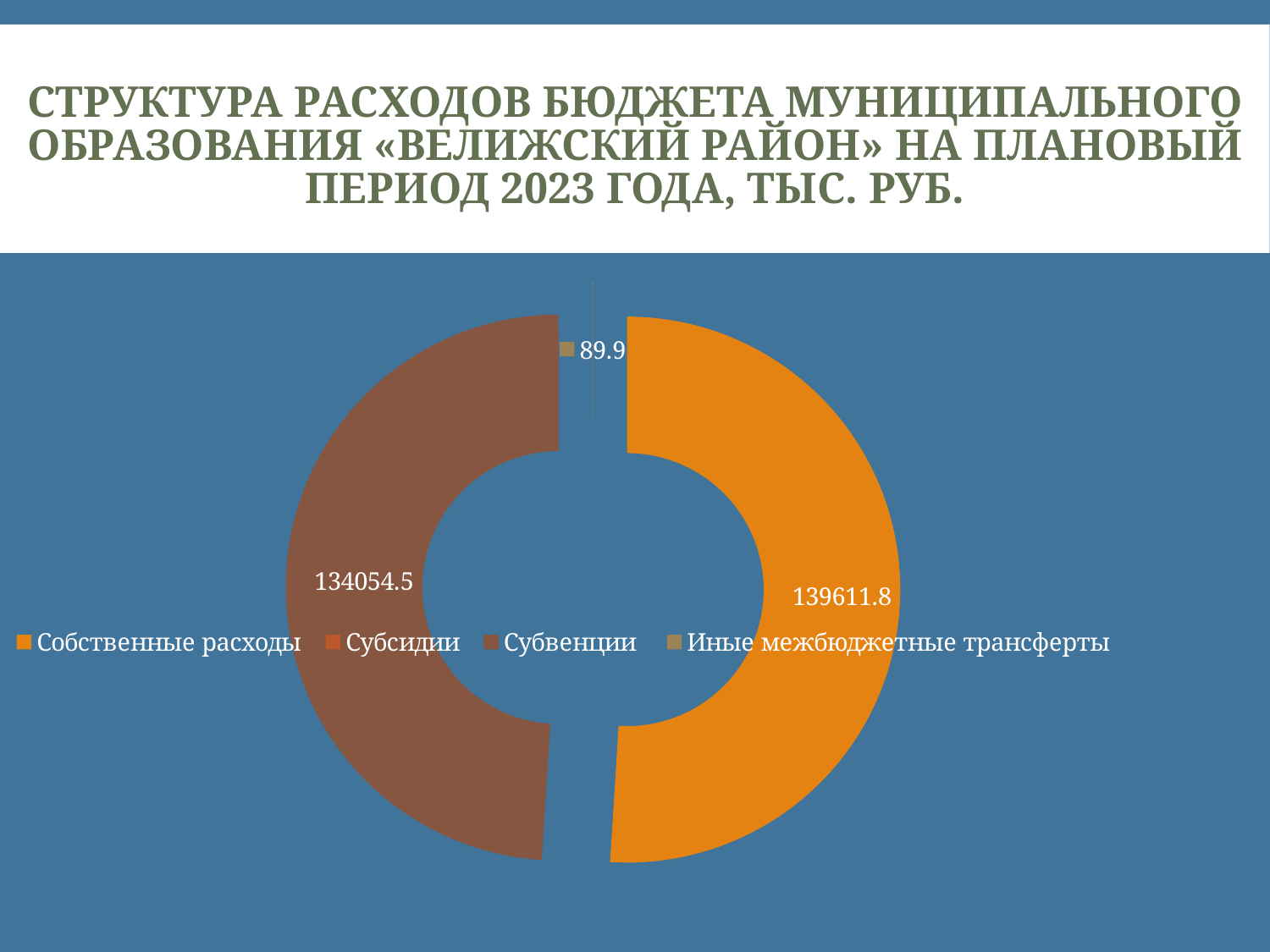
Which labeled category has the smallest value in the chart? Иные межбюджетные трансферты Which category has the largest value in the chart? Собственные расходы How many entries does the legend list? 4 What is the difference between the values for Собственные расходы and Субвенции? 5557.3 What is the value shown for Иные межбюджетные трансферты? 89.9 What kind of chart is shown on the slide? Doughnut (pie) chart What colour is the slice for Собственные расходы? Orange What unit of measurement is stated in the chart title? тыс. руб. What is the value shown for Собственные расходы? 139611.8 Which is larger, the value for Собственные расходы or the value for Субвенции? Собственные расходы What is the value shown for Субвенции? 134054.5